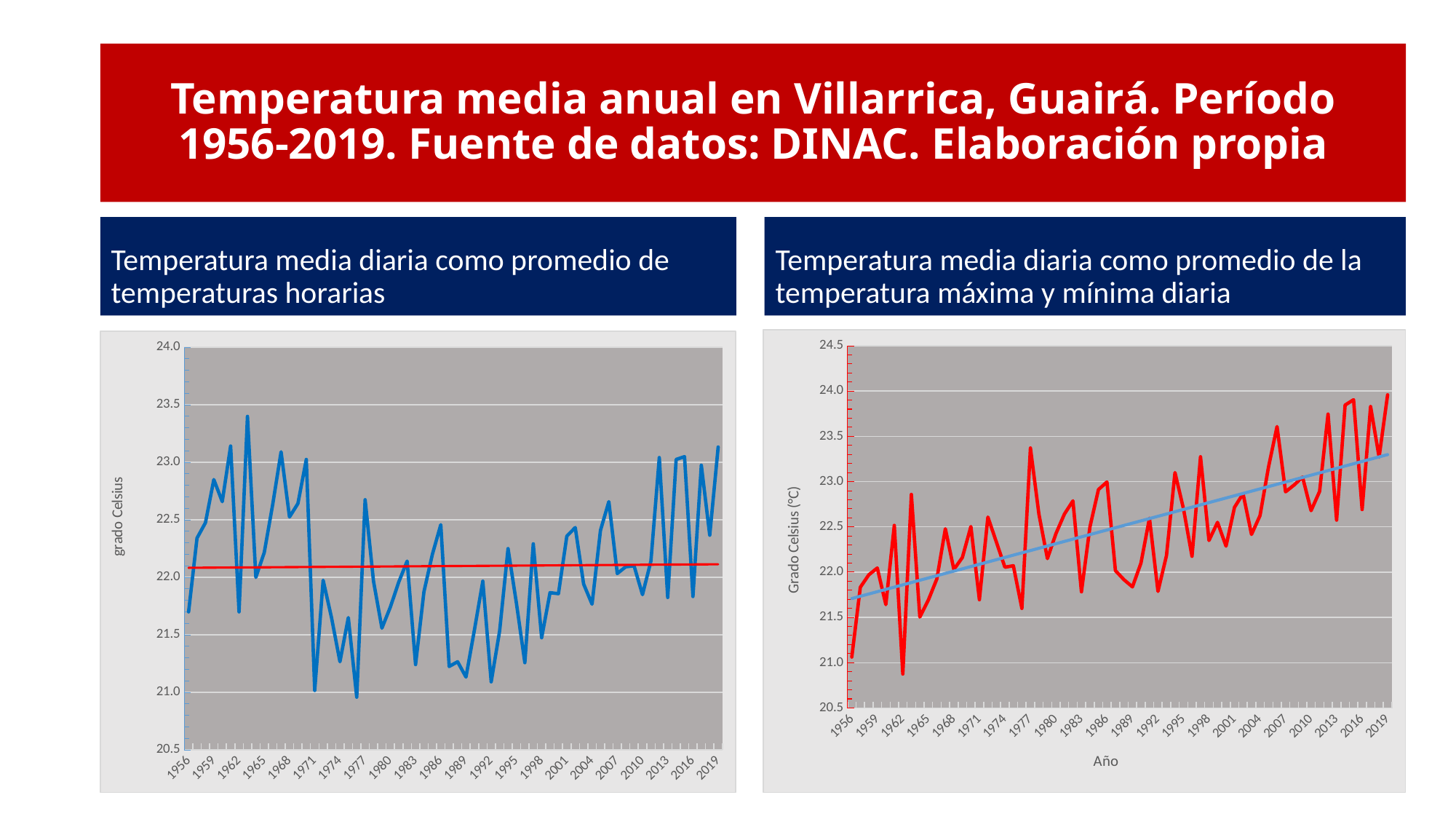
In the left chart, which year has the highest temperature? 1963 In the left chart, is the value for 1956 greater or less than 22.0? less In the right chart, is the value for 1963 greater or less than 21.5? greater What is the x-axis title of the right chart? Año What kind of chart is the left chart, 'Temperatura media diaria como promedio de temperaturas horarias'? Line chart In the right chart, do the values generally rise or fall from 1956 to 2019? Rise In the right chart, which year has the lowest temperature? 1962 In the right chart, is the value for 1977 greater or less than 23.0? greater What is the y-axis title of the left chart? grado Celsius What kind of chart is the right chart, 'Temperatura media diaria como promedio de la temperatura máxima y mínima diaria'? Line chart